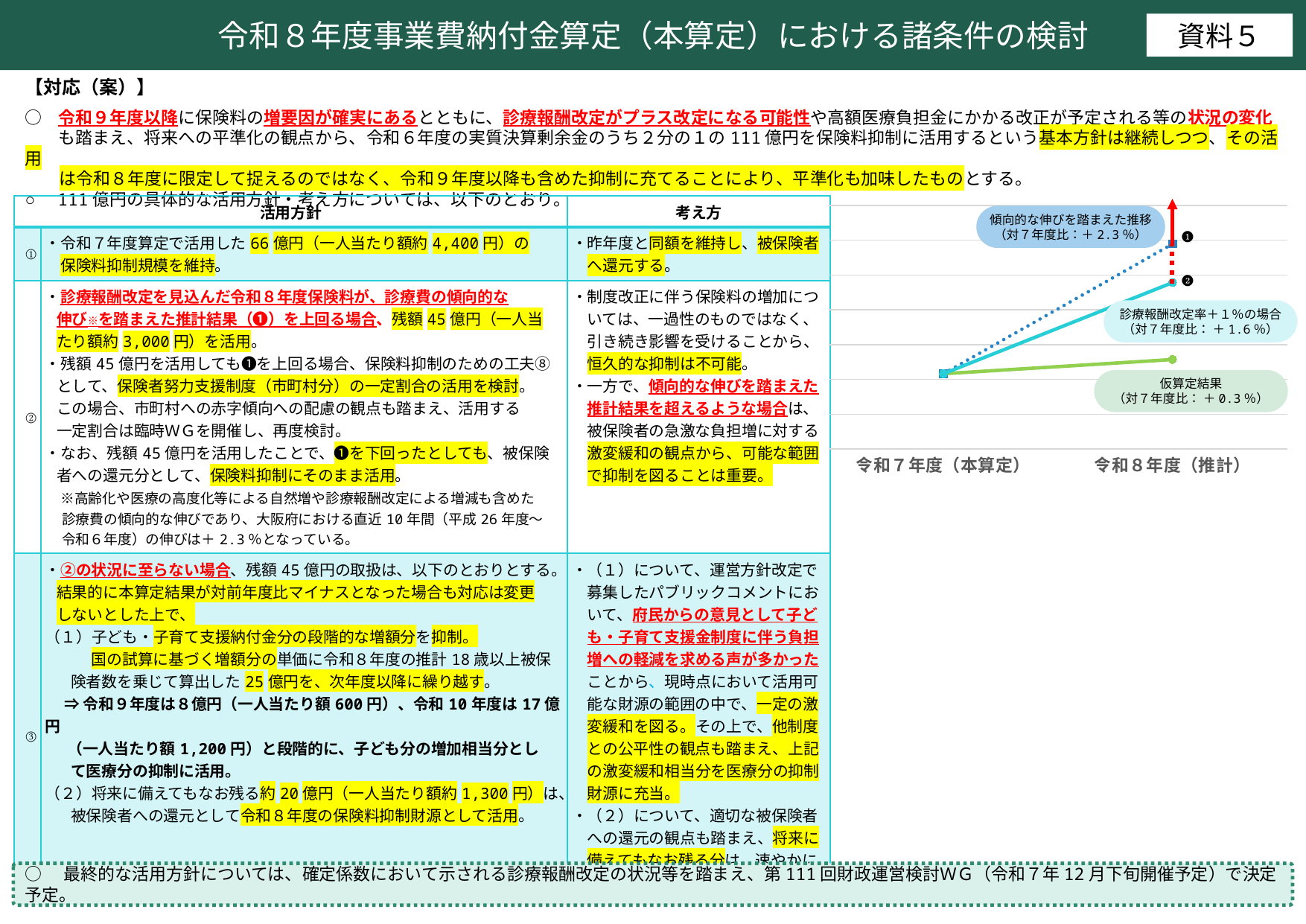
What are the two x-axis labels of the chart? 令和７年度（本算定）, 令和８年度（推計） In the chart, what 対７年度比 value is shown for 診療報酬改定率＋１％の場合? ＋1.6％ Do the lines in the chart rise or fall from 令和７年度（本算定） to 令和８年度（推計）? rise In the chart, what is the difference between the 対７年度比 of 傾向的な伸びを踏まえた推移 (＋2.3％) and 診療報酬改定率＋１％の場合 (＋1.6％)? 0.7％ In the chart, what 対７年度比 value is shown for 傾向的な伸びを踏まえた推移? ＋2.3％ How many lines are plotted in the chart? 3 In the chart, what 対７年度比 value is shown for 仮算定結果? ＋0.3％ Which line reaches the highest point at 令和８年度（推計） in the chart? 傾向的な伸びを踏まえた推移 Which line is lowest at 令和８年度（推計） in the chart? 仮算定結果 What kind of chart is shown on the right side of the slide? line chart In the chart, which is larger at 令和８年度（推計）: 診療報酬改定率＋１％の場合 or 仮算定結果? 診療報酬改定率＋１％の場合 How many categories are shown on the x axis of the chart? 2